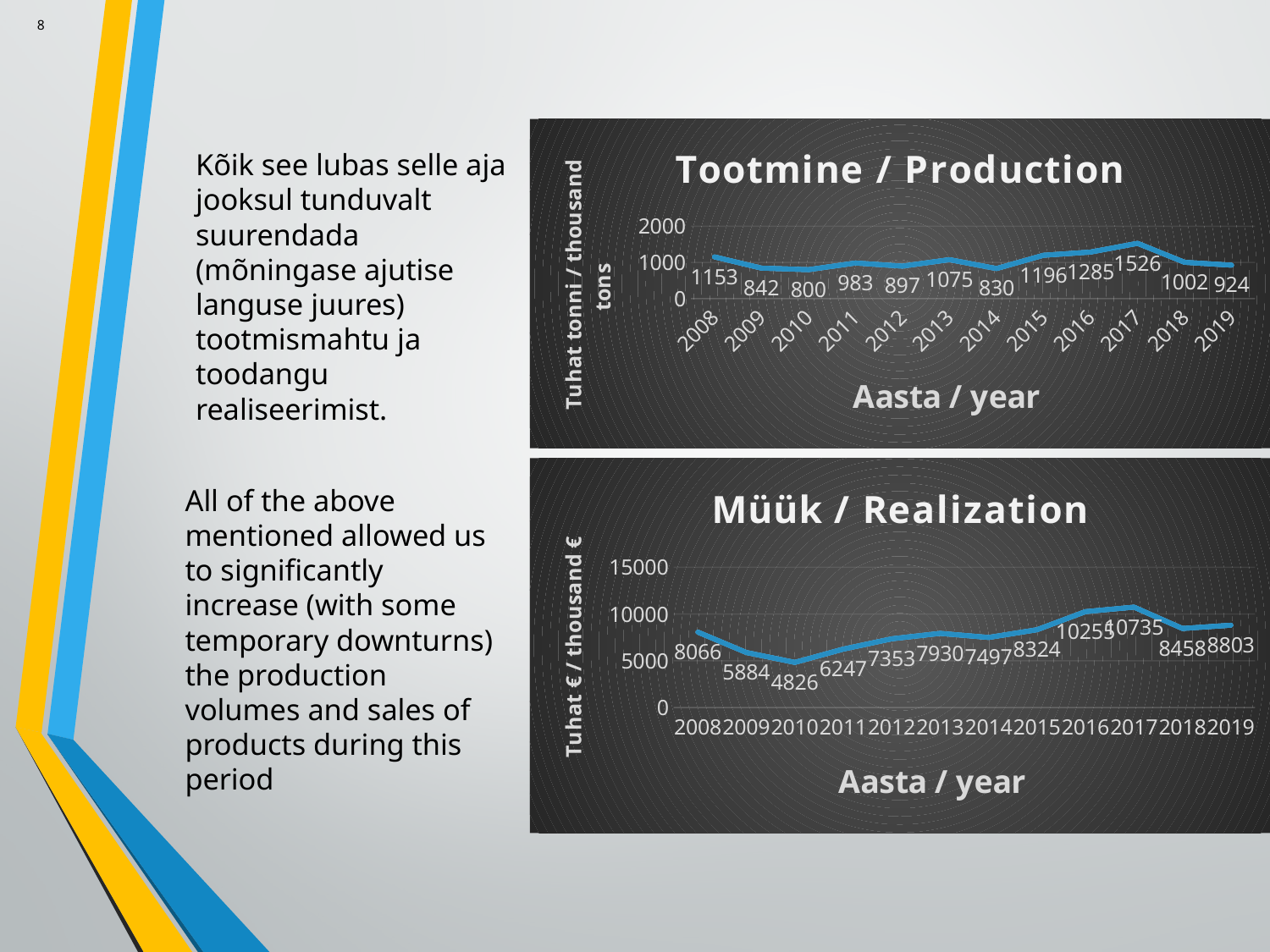
In the 'Müük / Realization' chart, what is the value for 2010? 4826 In the 'Müük / Realization' chart, which year has the highest value? 2017 What kind of chart is the 'Müük / Realization' chart? Line chart In the 'Müük / Realization' chart, is the value for 2016 larger than the value for 2019? Yes In the 'Tootmine / Production' chart, which year has the lowest value? 2010 In the 'Tootmine / Production' chart, which year has the highest value? 2017 In the 'Müük / Realization' chart, what is the difference between the 2008 value and the 2009 value? 2182 In the 'Tootmine / Production' chart, how many years are plotted on the x axis? 12 What is the y-axis label of the 'Müük / Realization' chart? Tuhat € / thousand € In the 'Tootmine / Production' chart, what is the value for 2017? 1526 In the 'Tootmine / Production' chart, what is the difference between the 2017 value and the 2018 value? 524 In the 'Tootmine / Production' chart, what is the value for 2008? 1153